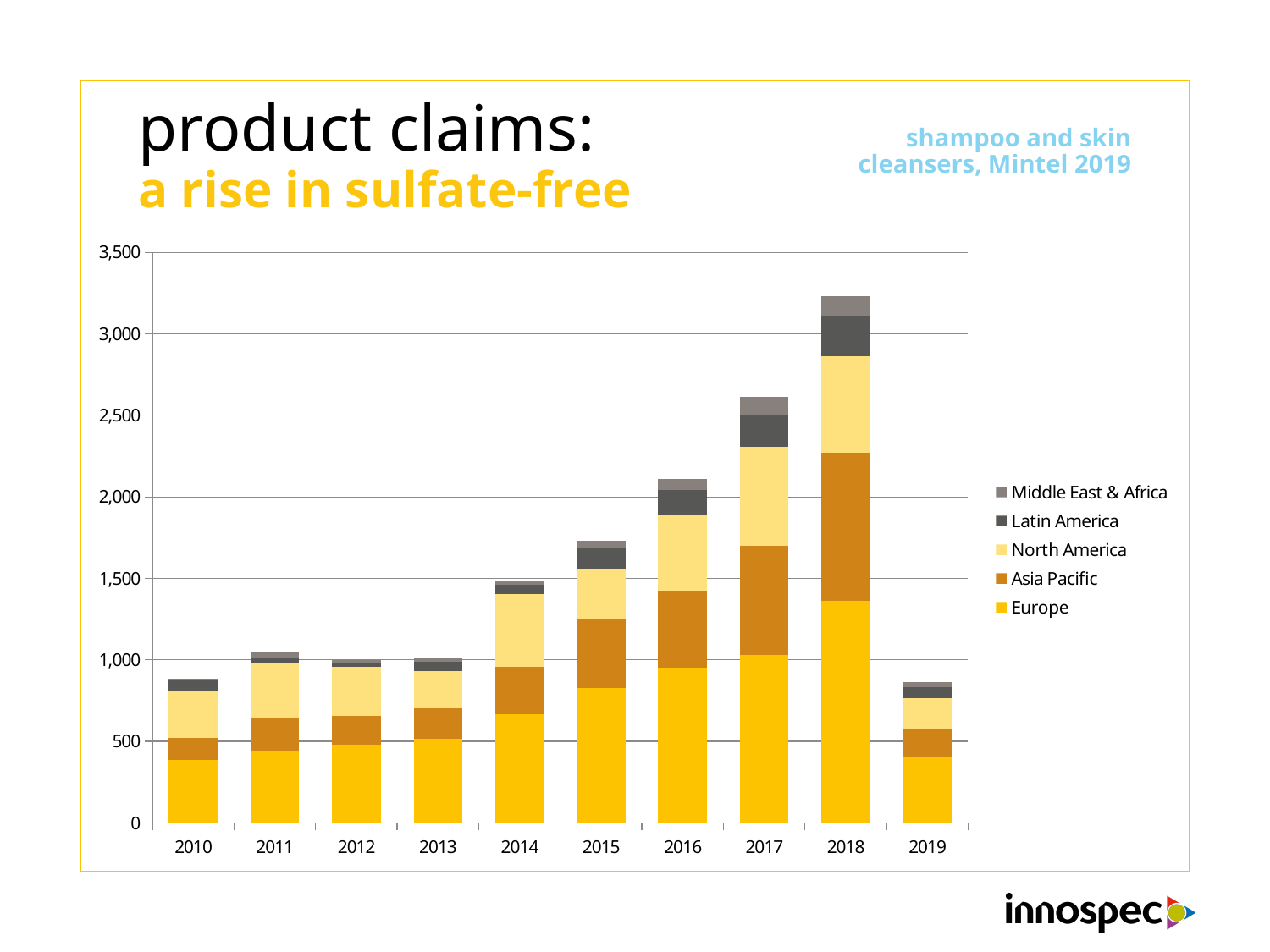
Which year has the tallest stacked bar? 2018 Is the total stacked value for 2015 greater or less than 1,500? greater What kind of chart is shown on the slide? stacked bar chart Which year has the larger total stacked bar, 2016 or 2017? 2017 Is the total stacked value for 2017 greater or less than 2,500? greater Is the Europe value for 2018 greater or less than 1,000? greater Do the total stacked values rise or fall from 2013 to 2018? rise How many series does the legend list? 5 Which series is shown at the bottom of each stacked bar? Europe How many years are shown along the x axis of the chart? 10